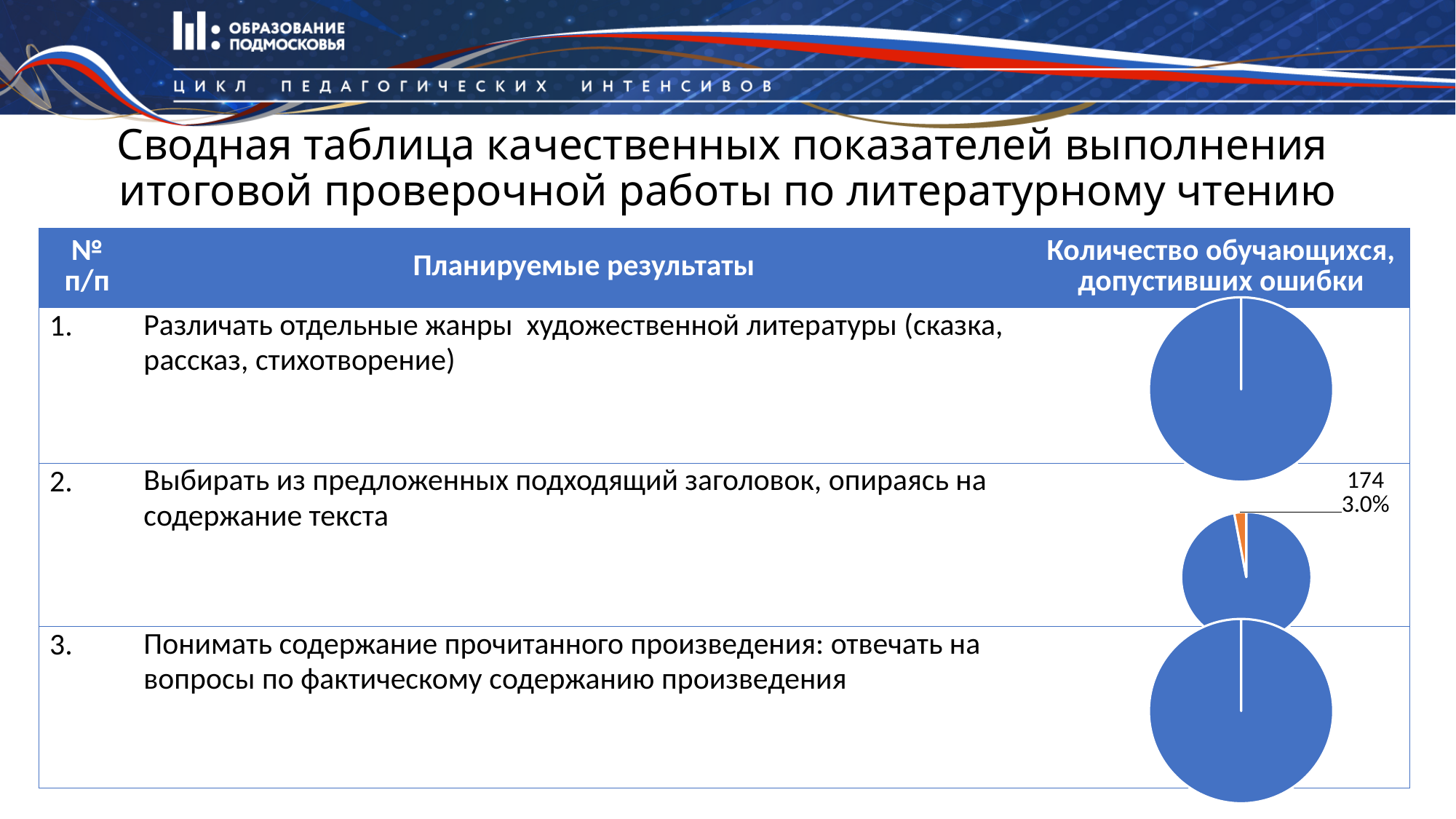
In the pie chart for row 2, what value is printed on the data label of the small orange slice? 174 What kind of chart is shown in the right-hand column for row 2 ("Выбирать из предложенных подходящий заголовок...")? pie chart In the pie chart for row 2, which slice is larger, the blue one or the orange one? blue What colour is the dominant slice in the pie chart for row 2? blue How many slices are visible in the pie chart for row 2? 2 In the pie chart for row 2, what percentage share is printed for the small orange slice? 3.0% What kind of chart is shown in the right-hand column for row 1 ("Различать отдельные жанры художественной литературы")? pie chart What colour fills the pie chart for row 3 ("Понимать содержание прочитанного произведения")? blue How many pie charts are shown on the slide? 3